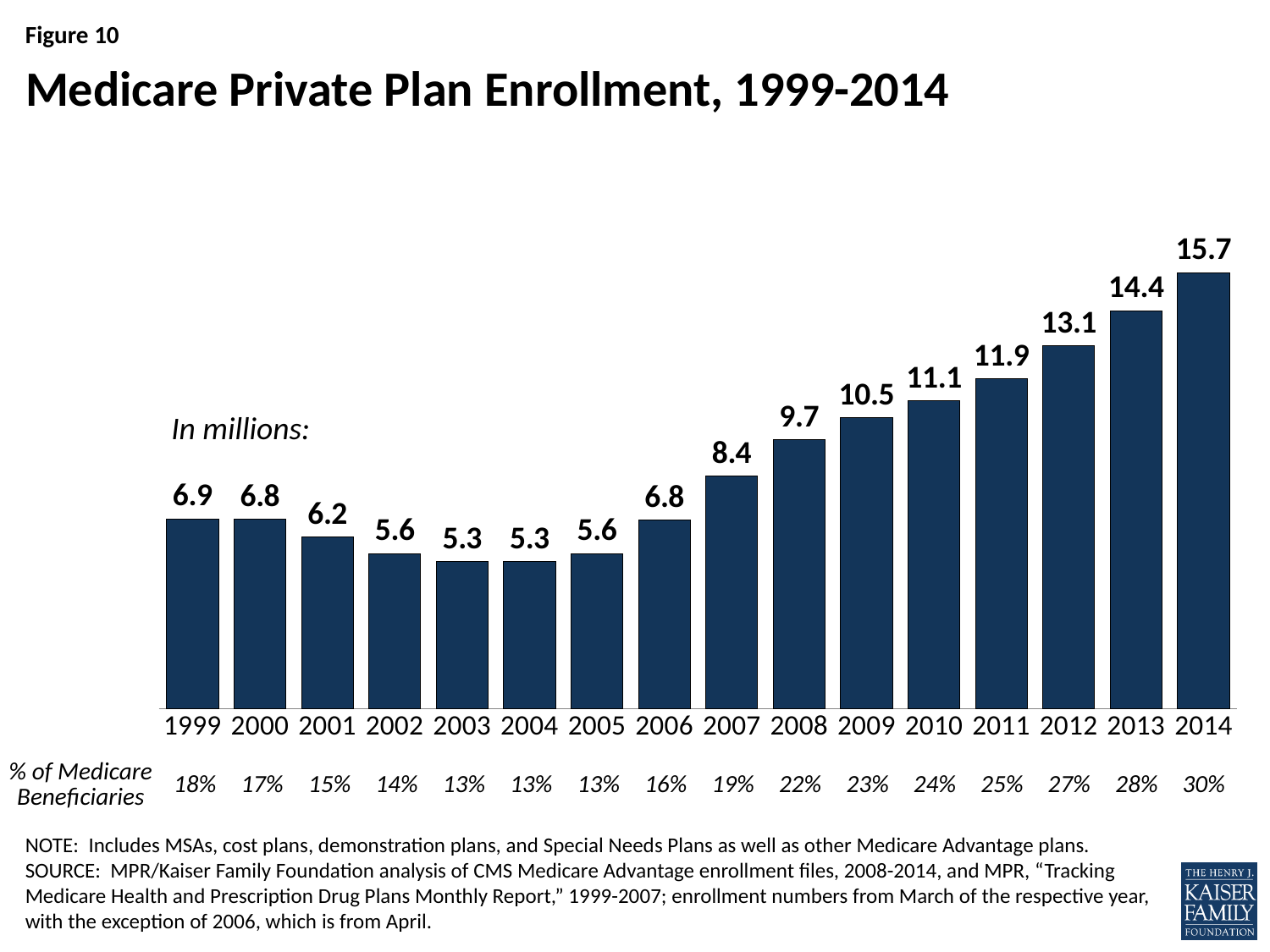
Which year has higher enrollment, 2006 or 2008? 2008 Do enrollment values rise or fall from 2005 to 2014? Rise Which year has the highest Medicare private plan enrollment? 2014 What kind of chart is shown on the slide? Bar chart Which years have the lowest Medicare private plan enrollment, at 5.3 million? 2003 and 2004 What percentage of Medicare beneficiaries were in private plans in 2010? 24% What is the title of the chart? Medicare Private Plan Enrollment, 1999-2014 How many years are shown on the x axis of the chart? 16 What is the difference in enrollment (in millions) between 2014 and 1999? 8.8 What is the difference in enrollment (in millions) between 2013 and 2012? 1.3 What is the Medicare private plan enrollment (in millions) for 2014? 15.7 What is the Medicare private plan enrollment (in millions) for 2007? 8.4